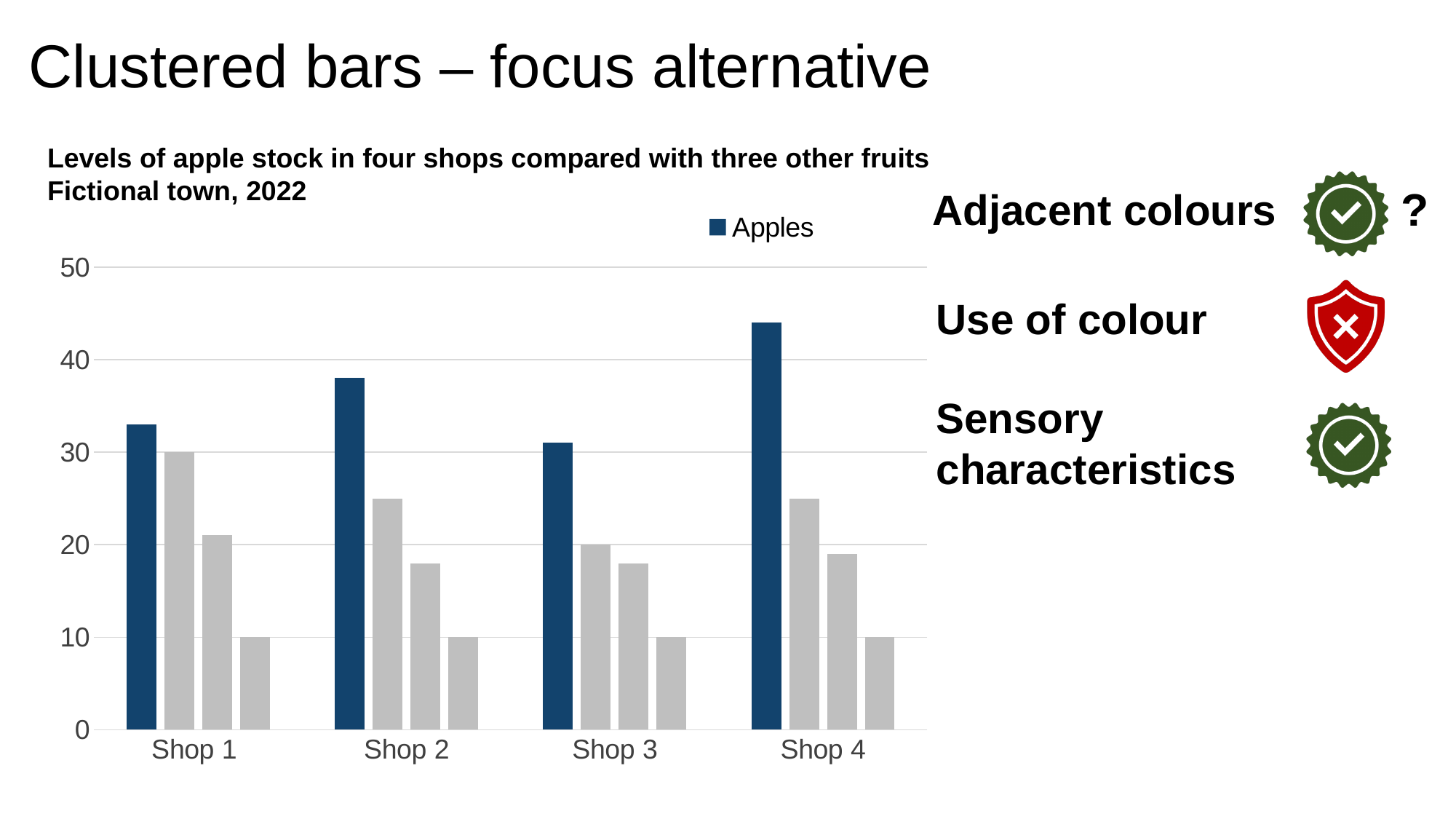
How many series does the chart's legend list? 1 Is the Apples value for Shop 2 greater or less than 40? less Is the Apples value for Shop 3 greater or less than 40? less Which has the larger Apples value, Shop 2 or Shop 4? Shop 4 What kind of chart is shown on the slide? bar chart Which has the larger Apples value, Shop 1 or Shop 2? Shop 2 What is the title of the chart? Levels of apple stock in four shops compared with three other fruits Fictional town, 2022 Is the Apples value for Shop 1 greater or less than 30? greater How many shops are shown on the x axis of the chart? 4 Which shop has the highest Apples bar? Shop 4 What is the only series named in the chart's legend? Apples